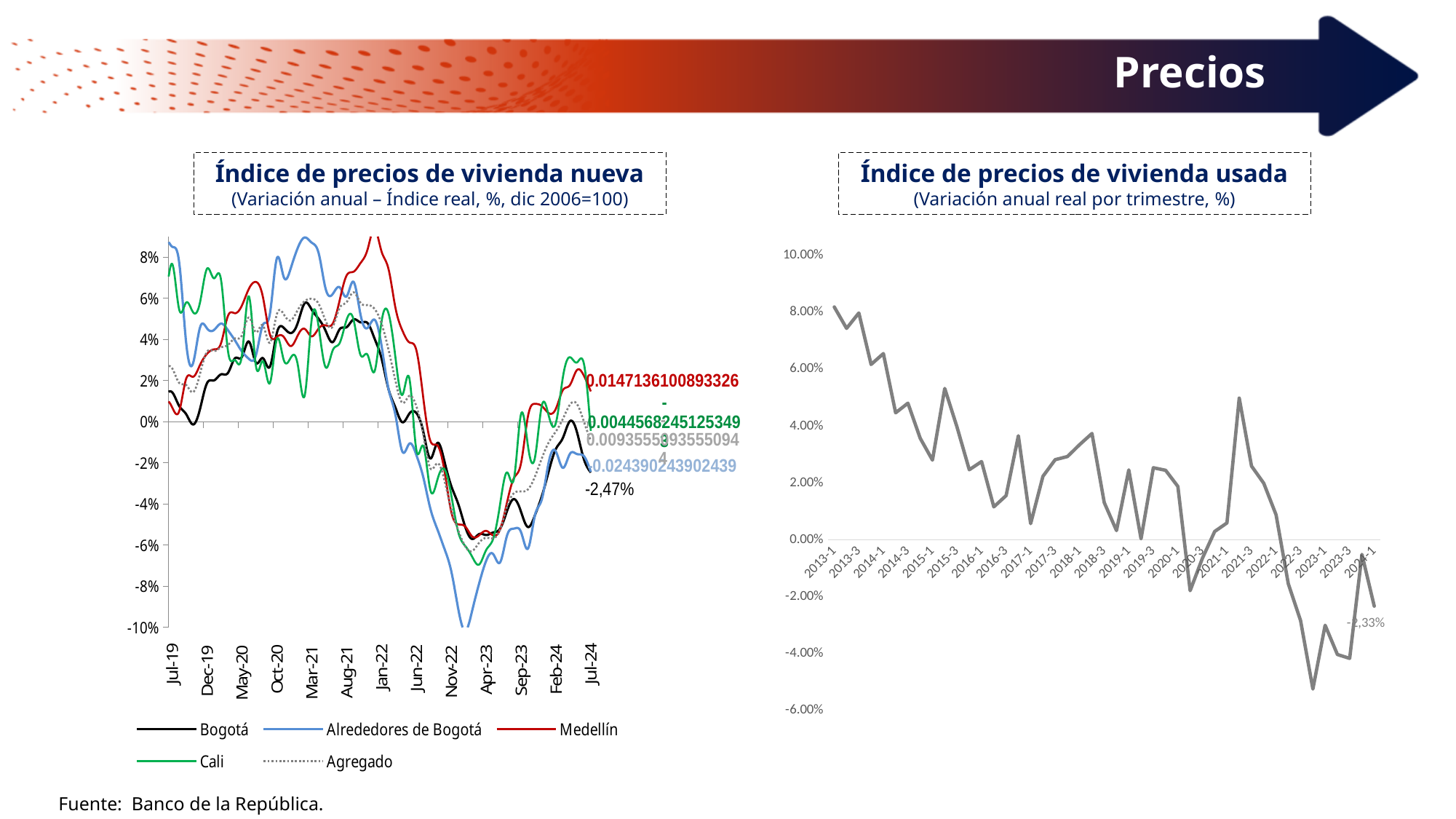
In the 'Índice de precios de vivienda usada' chart, is the value at 2013-1 greater or less than 6.00%? greater In the 'Índice de precios de vivienda nueva' chart, at Jul-24, which is higher: Medellín or Bogotá? Medellín In the 'Índice de precios de vivienda nueva' chart, which series reaches the lowest value over the period shown? Alrededores de Bogotá In the 'Índice de precios de vivienda usada' chart, is the lowest value on the line greater or less than -4.00%? less What kind of chart is the 'Índice de precios de vivienda nueva' chart on the left? Line chart How many series does the legend of the 'Índice de precios de vivienda nueva' chart list? 5 In the 'Índice de precios de vivienda usada' chart, what is the labelled value at the last point (2024-1)? -2,33% Which series are listed in the legend of the 'Índice de precios de vivienda nueva' chart? Bogotá, Alrededores de Bogotá, Medellín, Cali, Agregado In the 'Índice de precios de vivienda nueva' chart, what is the labelled value for Bogotá at Jul-24? -2,47% What kind of chart is the 'Índice de precios de vivienda usada' chart on the right? Line chart In the 'Índice de precios de vivienda usada' chart, do the values overall rise or fall from 2013-1 to 2024-1? Fall In the 'Índice de precios de vivienda nueva' chart, is the lowest value of Alrededores de Bogotá greater or less than -8%? less